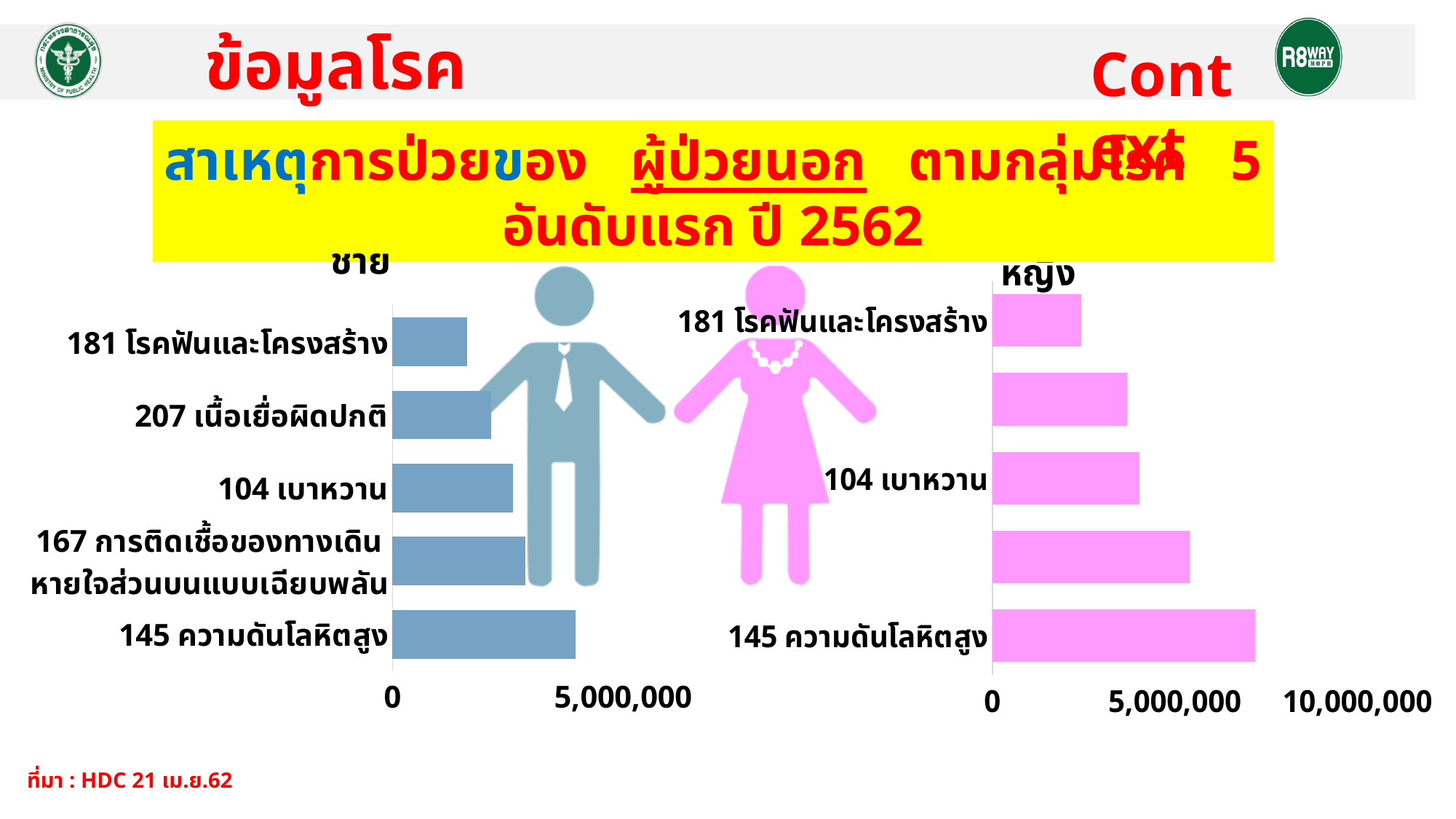
In the หญิง chart, which category has the lowest value? 181 โรคฟันและโครงสร้าง In the ชาย chart, which category has the lowest value? 181 โรคฟันและโครงสร้าง How many categories are shown in the ชาย chart? 5 What colour are the bars in the หญิง chart? pink In the ชาย chart, which category has the highest value? 145 ความดันโลหิตสูง What kind of chart is the ชาย chart on the left? bar chart In the หญิง chart, which category has the highest value? 145 ความดันโลหิตสูง In the ชาย chart, is the value for 145 ความดันโลหิตสูง greater or less than 5,000,000? less In the ชาย chart, which is larger: the value for 145 ความดันโลหิตสูง or the value for 181 โรคฟันและโครงสร้าง? 145 ความดันโลหิตสูง How many categories are shown in the หญิง chart? 5 In the หญิง chart, is the value for 181 โรคฟันและโครงสร้าง greater or less than 5,000,000? less In the หญิง chart, is the value for 145 ความดันโลหิตสูง greater or less than 5,000,000? greater